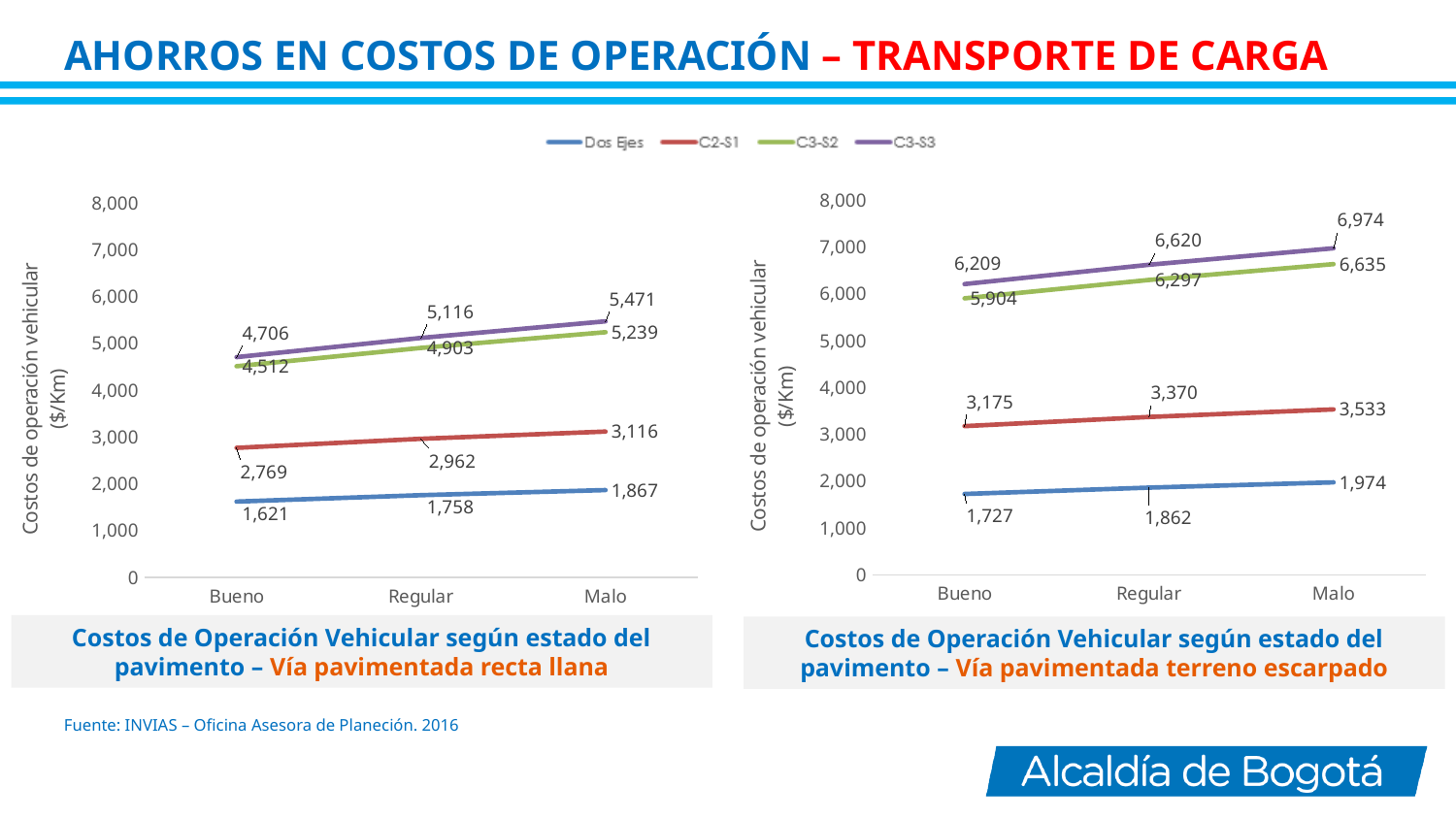
On the right chart (Vía pavimentada terreno escarpado), which series has the lowest value at Bueno? Dos Ejes On the left chart (Vía pavimentada recta llana), what is the value for Dos Ejes at Bueno? 1,621 On the right chart (Vía pavimentada terreno escarpado), which is larger: the C2-S1 value at Malo or the C3-S2 value at Bueno? C3-S2 at Bueno On the right chart (Vía pavimentada terreno escarpado), what is the value for C3-S3 at Malo? 6,974 How many pavement-condition categories are shown on the x axis of the left chart? 3 What kind of chart is the right chart (Vía pavimentada terreno escarpado)? Line chart On the left chart (Vía pavimentada recta llana), what is the value for C2-S1 at Regular? 2,962 On the right chart (Vía pavimentada terreno escarpado), do the Dos Ejes values rise or fall from Bueno to Malo? Rise On the left chart (Vía pavimentada recta llana), which series has the highest value at Malo? C3-S3 On the left chart (Vía pavimentada recta llana), what is the difference between the C3-S3 value at Malo and the C3-S3 value at Bueno? 765 On the right chart (Vía pavimentada terreno escarpado), what is the value for C3-S2 at Regular? 6,297 How many series does the legend list? 4